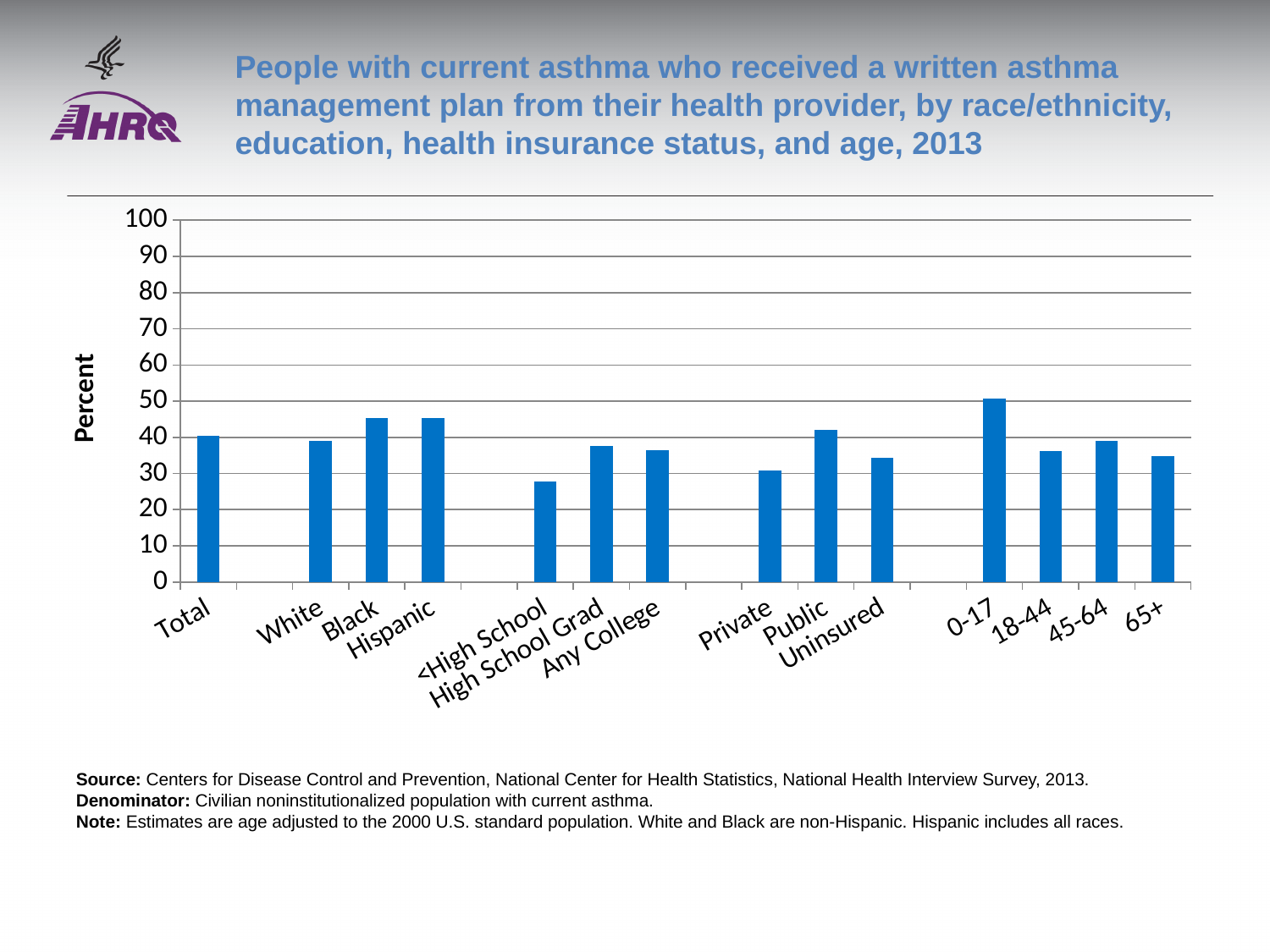
Which is larger, the value for Black or the value for <High School? Black What is the label on the vertical axis of the chart? Percent Is the value for Total greater or less than 30? greater Is the value for <High School greater or less than 30? less Is the value for Uninsured greater or less than 40? less Which category has the highest value in the chart? 0-17 How many categories (bars) are plotted in the chart? 14 What kind of chart is shown on the slide? bar chart Which category has the lowest value in the chart? <High School Which is larger, the value for Public or the value for Private? Public